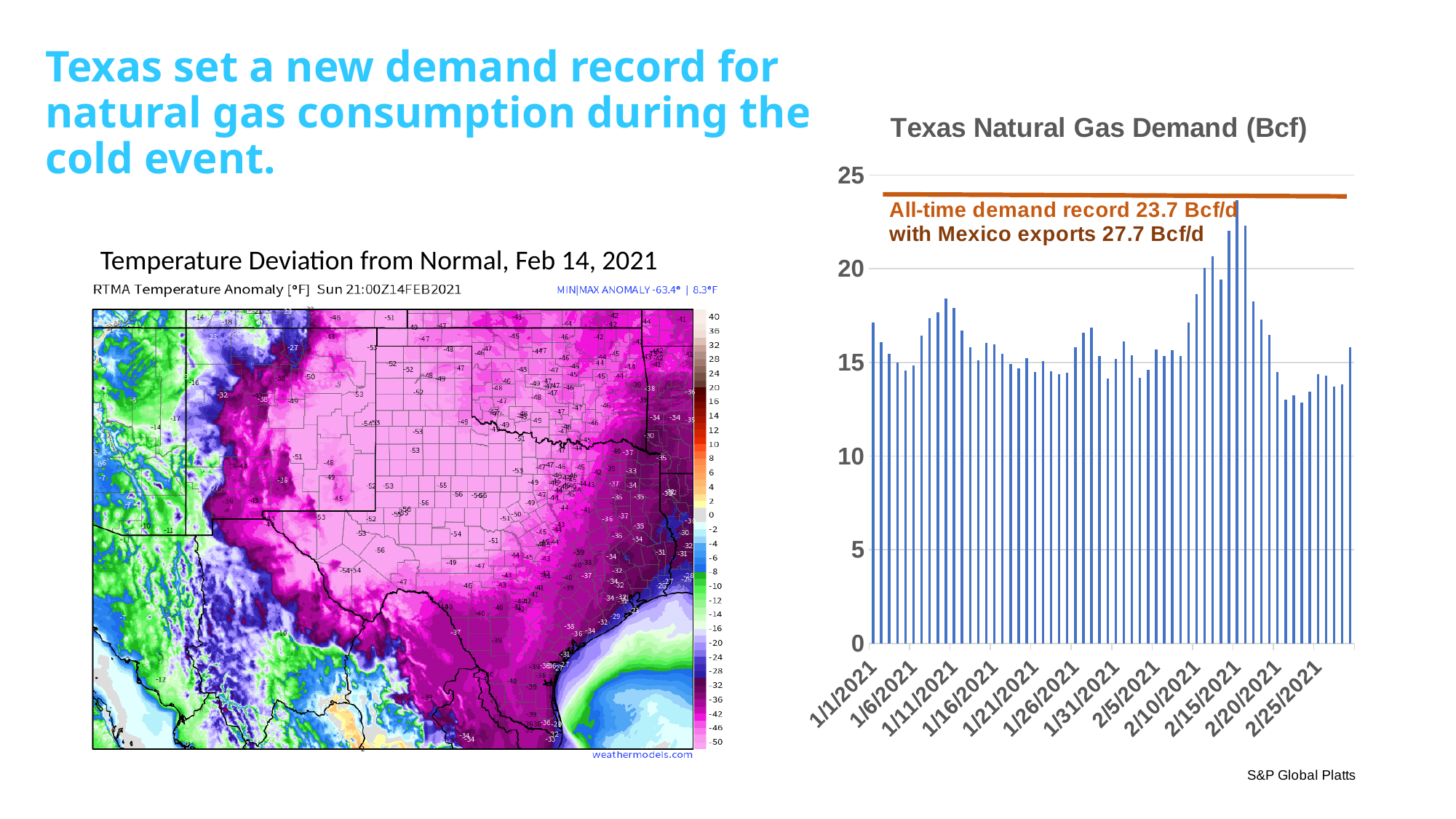
What is the title of the chart on the right side of the slide? Texas Natural Gas Demand (Bcf) In the Texas Natural Gas Demand chart, what all-time demand record value is annotated? 23.7 Bcf/d In the Texas Natural Gas Demand chart, near which x-axis label does the tallest bar appear? 2/15/2021 What is the highest value shown on the y axis of the Texas Natural Gas Demand chart? 25 In the Texas Natural Gas Demand chart, what is the annotated demand record including Mexico exports? 27.7 Bcf/d In the Texas Natural Gas Demand chart, is the value for 1/21/2021 greater or less than 15? less In the Texas Natural Gas Demand chart, is the value for 1/1/2021 greater or less than 15? greater In the Texas Natural Gas Demand chart, do the values rise or fall between 2/10/2021 and 2/15/2021? rise In the Texas Natural Gas Demand chart, is the value for 2/25/2021 greater or less than 15? less What kind of chart is the Texas Natural Gas Demand (Bcf) chart? bar chart In the Texas Natural Gas Demand chart, which is larger, the value for 1/1/2021 or the value for 1/21/2021? 1/1/2021